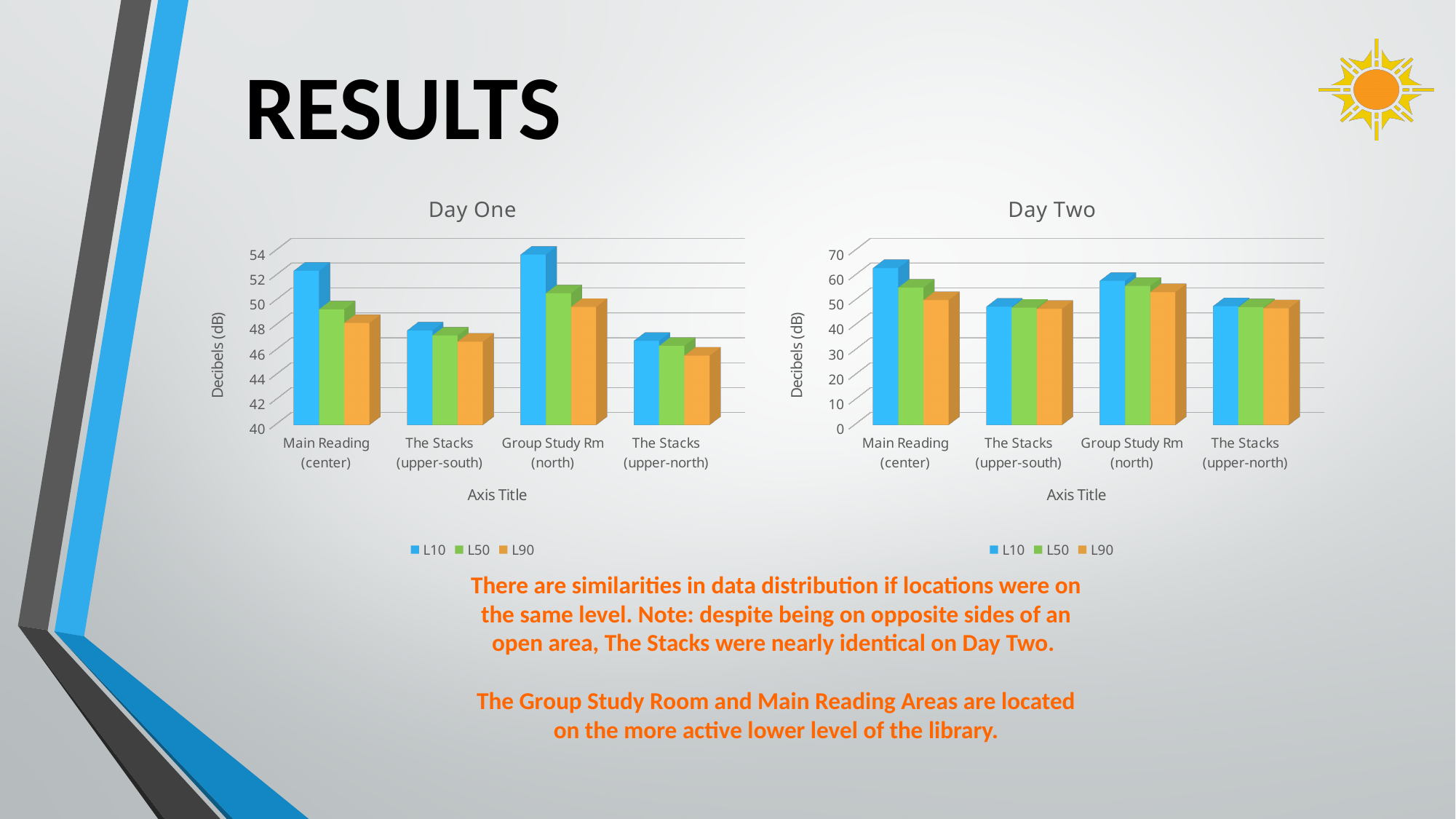
How many location categories are shown on the x axis of the Day One chart? 4 In the Day One chart, which location has the highest L10 value? Group Study Rm (north) In the Day One chart, which location has the lowest L10 value? The Stacks (upper-north) What kind of chart is the Day One chart? bar chart How many series does the legend of the Day Two chart list? 3 In the Day Two chart, which location has the highest L10 value? Main Reading (center) What is the label on the vertical axis of the Day One chart? Decibels (dB) In the Day Two chart, is the L10 value for Main Reading (center) greater or less than 60? greater In the Day Two chart, is the L90 value for The Stacks (upper-south) greater or less than 50? less In the Day Two chart, which is larger: the L10 value for Main Reading (center) or the L10 value for Group Study Rm (north)? Main Reading (center) In the Day One chart, which is larger for Group Study Rm (north): the L10 value or the L90 value? L10 In the Day One chart, is the L10 value for Main Reading (center) greater or less than 50? greater